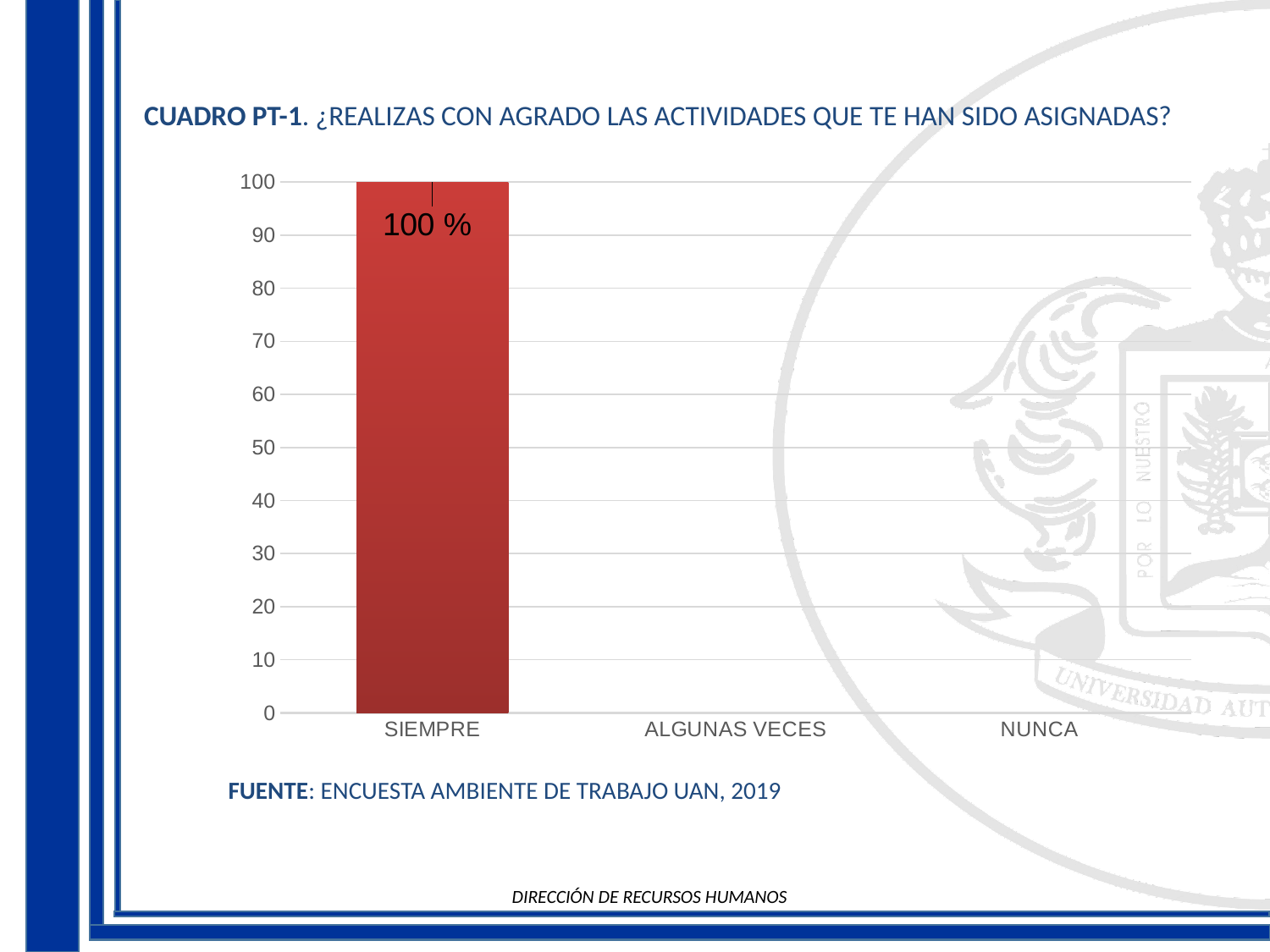
What is the highest tick value shown on the vertical axis? 100 Which is larger, the value for SIEMPRE or the value for ALGUNAS VECES? SIEMPRE What is the source cited below the chart? ENCUESTA AMBIENTE DE TRABAJO UAN, 2019 Is the value for NUNCA greater or less than 10? less What value is shown for SIEMPRE? 100 % How many categories are shown on the x axis? 3 What kind of chart is shown on the slide? Bar chart Is the value for SIEMPRE greater or less than 90? greater Which is larger, the value for SIEMPRE or the value for NUNCA? SIEMPRE Which category has the highest value? SIEMPRE Is the value for ALGUNAS VECES greater or less than 50? less